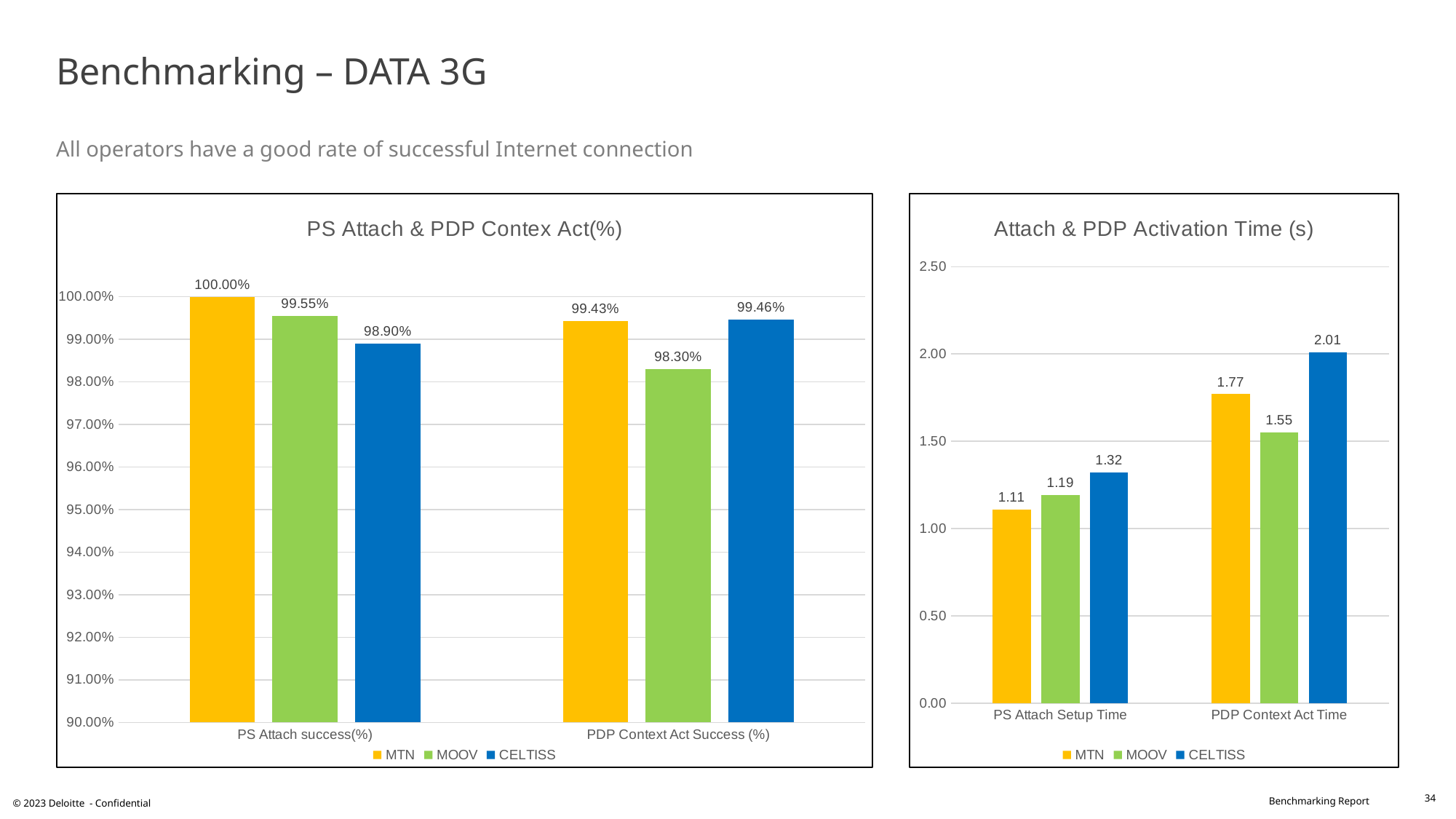
In the 'PS Attach & PDP Contex Act(%)' chart, what is the value for MTN in PS Attach success(%)? 100.00% In the 'Attach & PDP Activation Time (s)' chart, what is the value for CELTISS in PDP Context Act Time? 2.01 What kind of chart is the 'Attach & PDP Activation Time (s)' chart? Bar chart In the 'Attach & PDP Activation Time (s)' chart, what is the difference between CELTISS and MTN in PDP Context Act Time? 0.24 In the 'Attach & PDP Activation Time (s)' chart, which operator has the lowest PS Attach Setup Time? MTN In the 'PS Attach & PDP Contex Act(%)' chart, what is the difference between MTN and CELTISS in PS Attach success(%)? 1.10% In the 'PS Attach & PDP Contex Act(%)' chart, which is larger for PDP Context Act Success (%): MTN or MOOV? MTN In the 'Attach & PDP Activation Time (s)' chart, is the value for MOOV in PDP Context Act Time greater or less than 1.50? greater How many series does the legend of the 'PS Attach & PDP Contex Act(%)' chart list? 3 In the 'PS Attach & PDP Contex Act(%)' chart, which operator has the lowest PS Attach success(%)? CELTISS In the 'PS Attach & PDP Contex Act(%)' chart, what is the value for MOOV in PDP Context Act Success (%)? 98.30% How many categories are shown on the x axis of the 'Attach & PDP Activation Time (s)' chart? 2